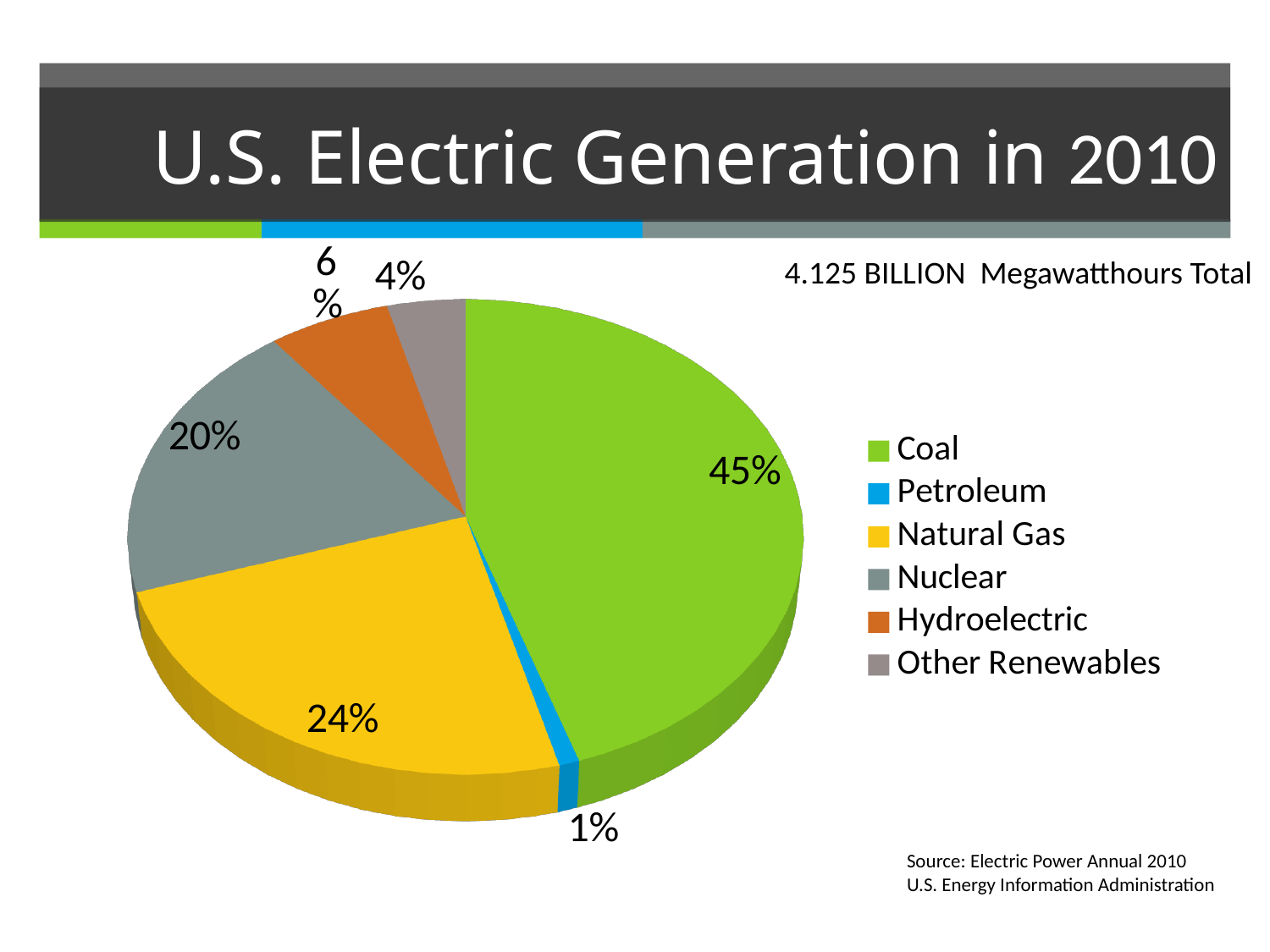
How many percentage points larger is the Coal share than the Natural Gas share? 21 Which source has the smallest share of the pie? Petroleum What total generation figure is stated on the slide? 4.125 BILLION Megawatthours Which source has the largest share of the pie? Coal How many categories does the legend list? 6 What share of U.S. electric generation in 2010 came from Petroleum? 1% Which has a larger share, Nuclear or Hydroelectric? Nuclear What share of U.S. electric generation in 2010 came from Natural Gas? 24% What share of U.S. electric generation in 2010 came from Coal? 45% What share of U.S. electric generation in 2010 came from Nuclear? 20% What kind of chart is shown on the slide? Pie chart What share of U.S. electric generation in 2010 came from Hydroelectric? 6%